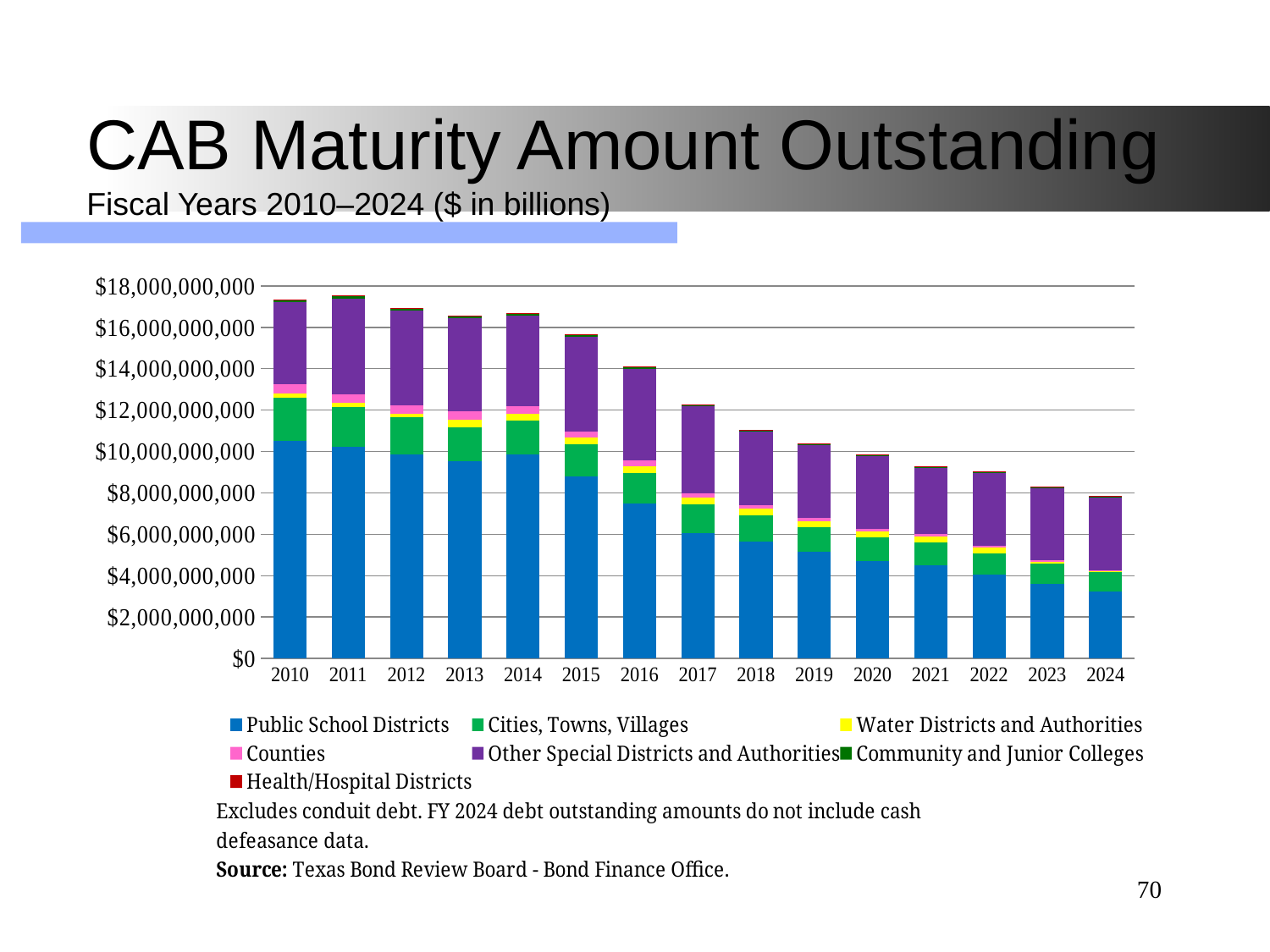
How many fiscal years are shown on the x axis of the chart? 15 Is the Public School Districts value for 2024 greater or less than $4,000,000,000? less Is the total bar for 2016 greater or less than $12,000,000,000? greater What kind of chart is shown on the slide? Stacked bar chart Which series is shown in purple in the chart? Other Special Districts and Authorities Which fiscal year has the lowest total CAB maturity amount outstanding? 2024 Is the Public School Districts value for 2010 greater or less than $10,000,000,000? greater How many series does the chart's legend list? 7 What is the subtitle of the chart on the slide? Fiscal Years 2010–2024 ($ in billions) Do the total bar heights generally rise or fall from 2010 to 2024? Fall Which year has a larger total bar, 2010 or 2015? 2010